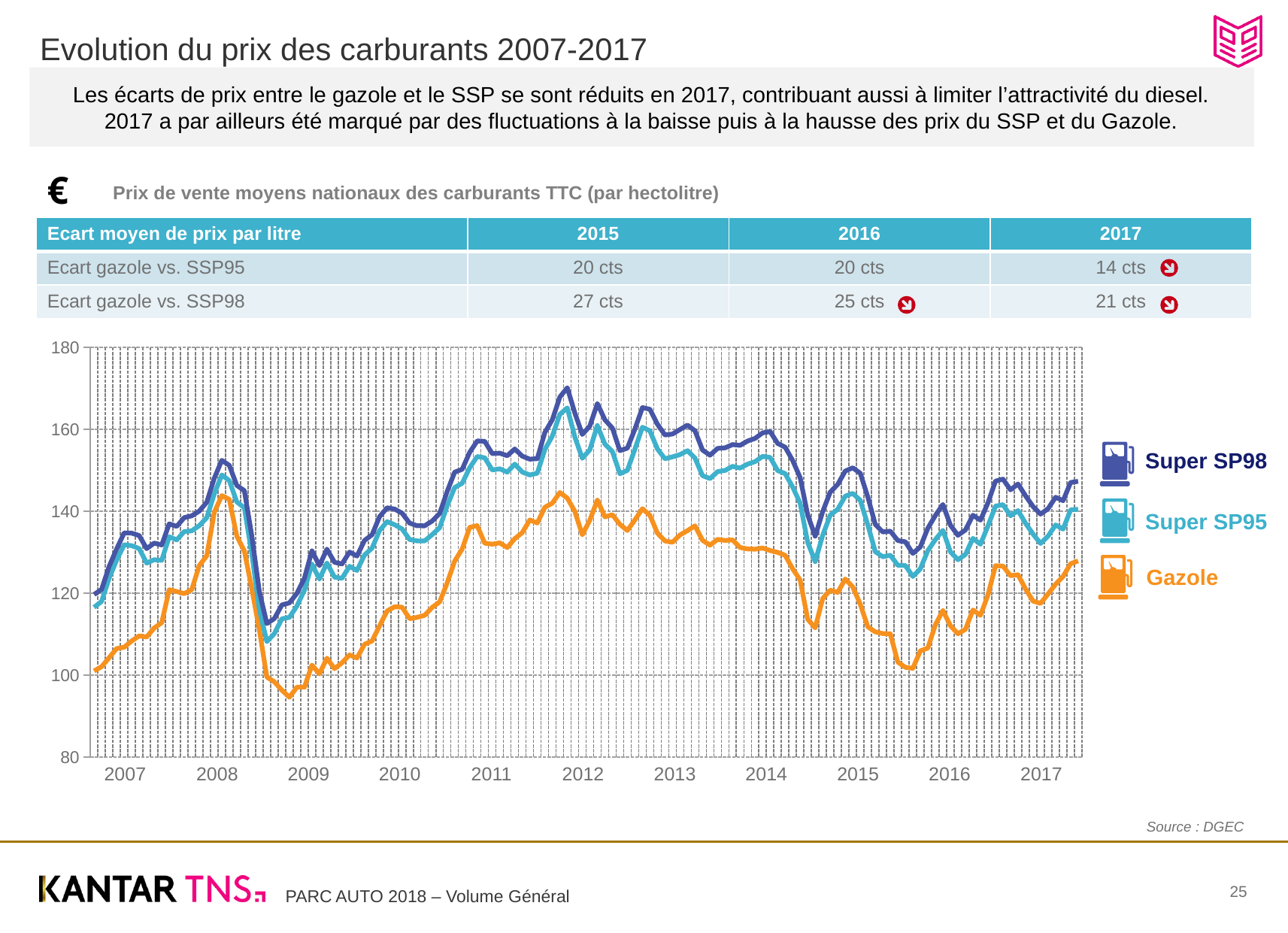
Is the peak value of Super SP98 in 2012 greater or less than 160? greater What kind of chart is shown on the slide? line chart Which is higher at the end of 2017, Super SP98 or Gazole? Super SP98 Which three fuels are listed in the chart's legend? Super SP98, Super SP95, Gazole How many year labels are shown on the x axis of the chart? 11 Is the value for Gazole at the end of 2017 greater or less than 140? less Is the lowest value of Gazole at the end of 2008 greater or less than 100? less How many series does the chart's legend list? 3 Which series has the lowest values across the whole period shown in the chart? Gazole Which series has the highest values across the whole period shown in the chart? Super SP98 Do the prices of the three fuels rise or fall between 2009 and 2012? rise